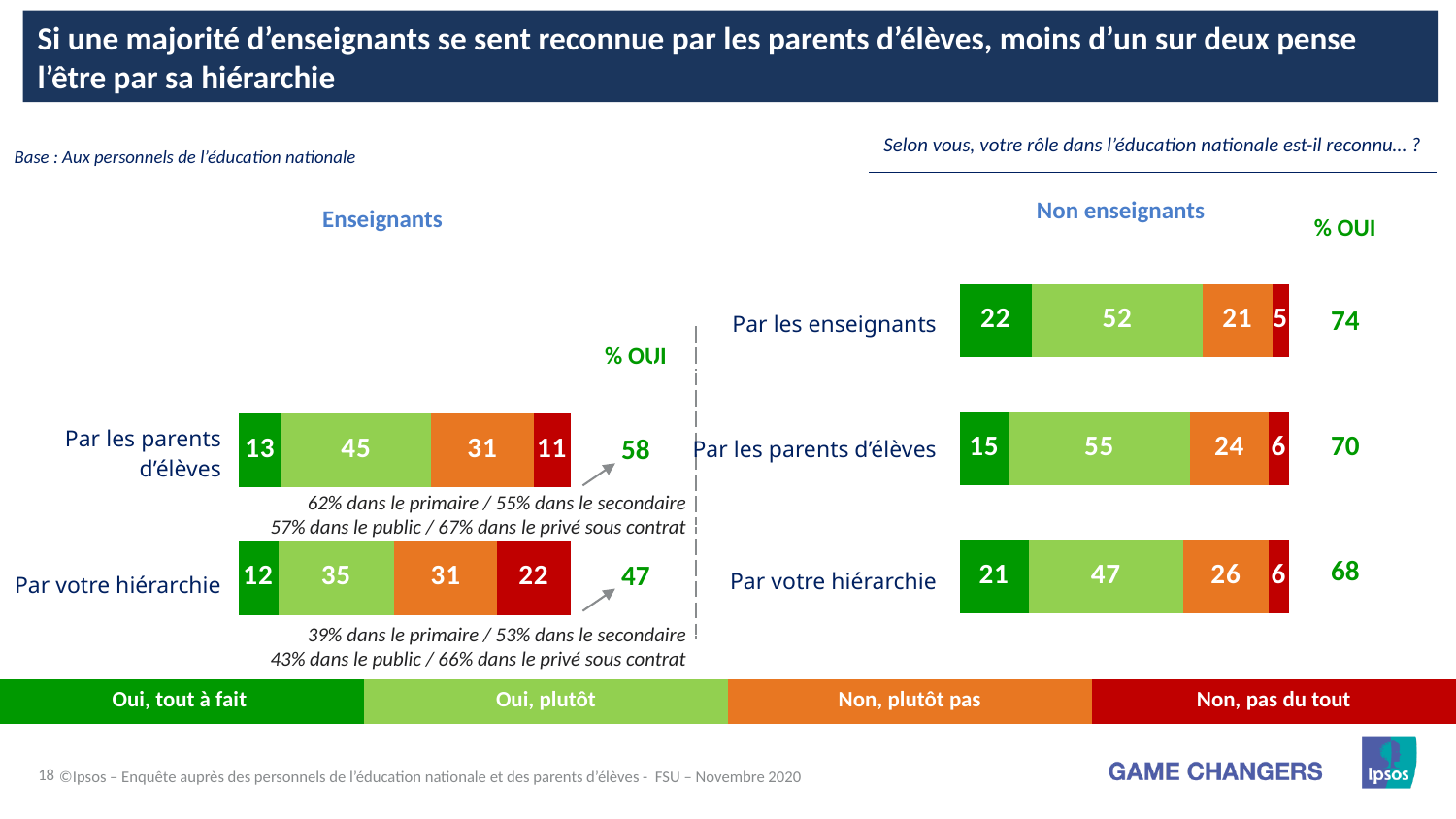
In the Non enseignants chart, what is the % OUI for 'Par votre hiérarchie'? 68 In the Enseignants chart, which category has the lowest % OUI? Par votre hiérarchie How many series does the legend at the bottom of the slide list? 4 What type of chart is the Enseignants chart? Stacked bar chart In the Non enseignants chart, what is the 'Oui, tout à fait' value for 'Par les enseignants'? 22 In the Enseignants chart, what is the difference in % OUI between 'Par les parents d'élèves' and 'Par votre hiérarchie'? 11 In the Enseignants chart, what is the 'Oui, plutôt' value for 'Par les parents d'élèves'? 45 In the Non enseignants chart, what is the total of the 'Oui, tout à fait' and 'Oui, plutôt' segments for 'Par les parents d'élèves'? 70 In the Non enseignants chart, which category has the highest % OUI? Par les enseignants In the Enseignants chart, what is the 'Non, pas du tout' value for 'Par votre hiérarchie'? 22 In the Non enseignants chart, which is larger: the 'Oui, plutôt' value for 'Par les parents d'élèves' or for 'Par votre hiérarchie'? Par les parents d'élèves How many categories does the Non enseignants chart show? 3